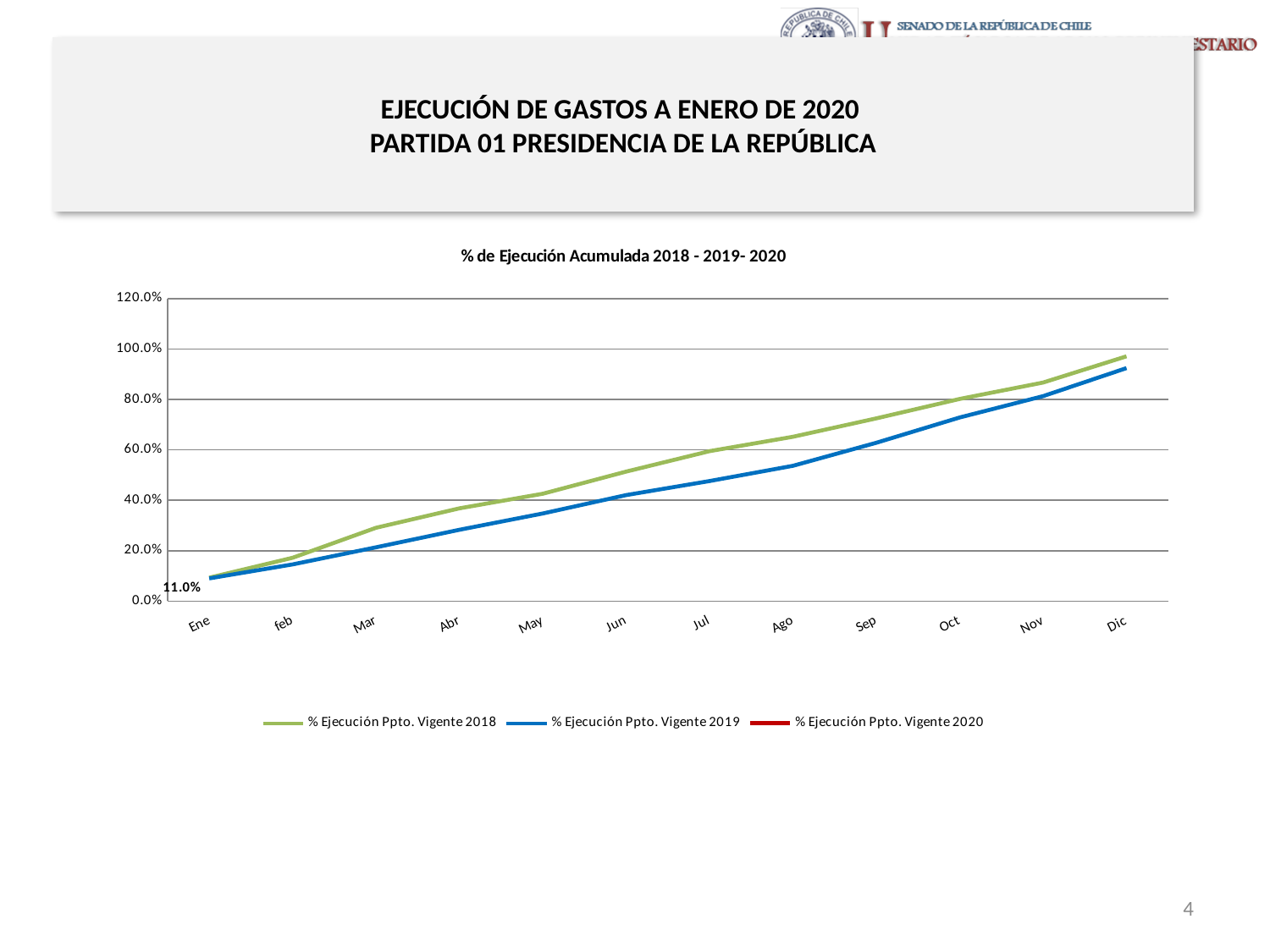
What kind of chart is shown on the slide? line chart Do the values for % Ejecución Ppto. Vigente 2018 rise or fall from Ene to Dic? rise In which month does % Ejecución Ppto. Vigente 2018 reach its highest value? Dic How many months are shown along the x axis? 12 What data label is printed at Ene on the chart? 11.0% Is the value for % Ejecución Ppto. Vigente 2019 at Jun greater or less than 60.0%? less At Sep, which series has the higher value: % Ejecución Ppto. Vigente 2018 or % Ejecución Ppto. Vigente 2019? % Ejecución Ppto. Vigente 2018 Is the value for % Ejecución Ppto. Vigente 2018 at Dic greater or less than 80.0%? greater How many series does the legend list? 3 What is the title of the chart? % de Ejecución Acumulada 2018 - 2019- 2020 In which month is % Ejecución Ppto. Vigente 2019 at its lowest value? Ene Is the value for % Ejecución Ppto. Vigente 2018 at Mar greater or less than 20.0%? greater